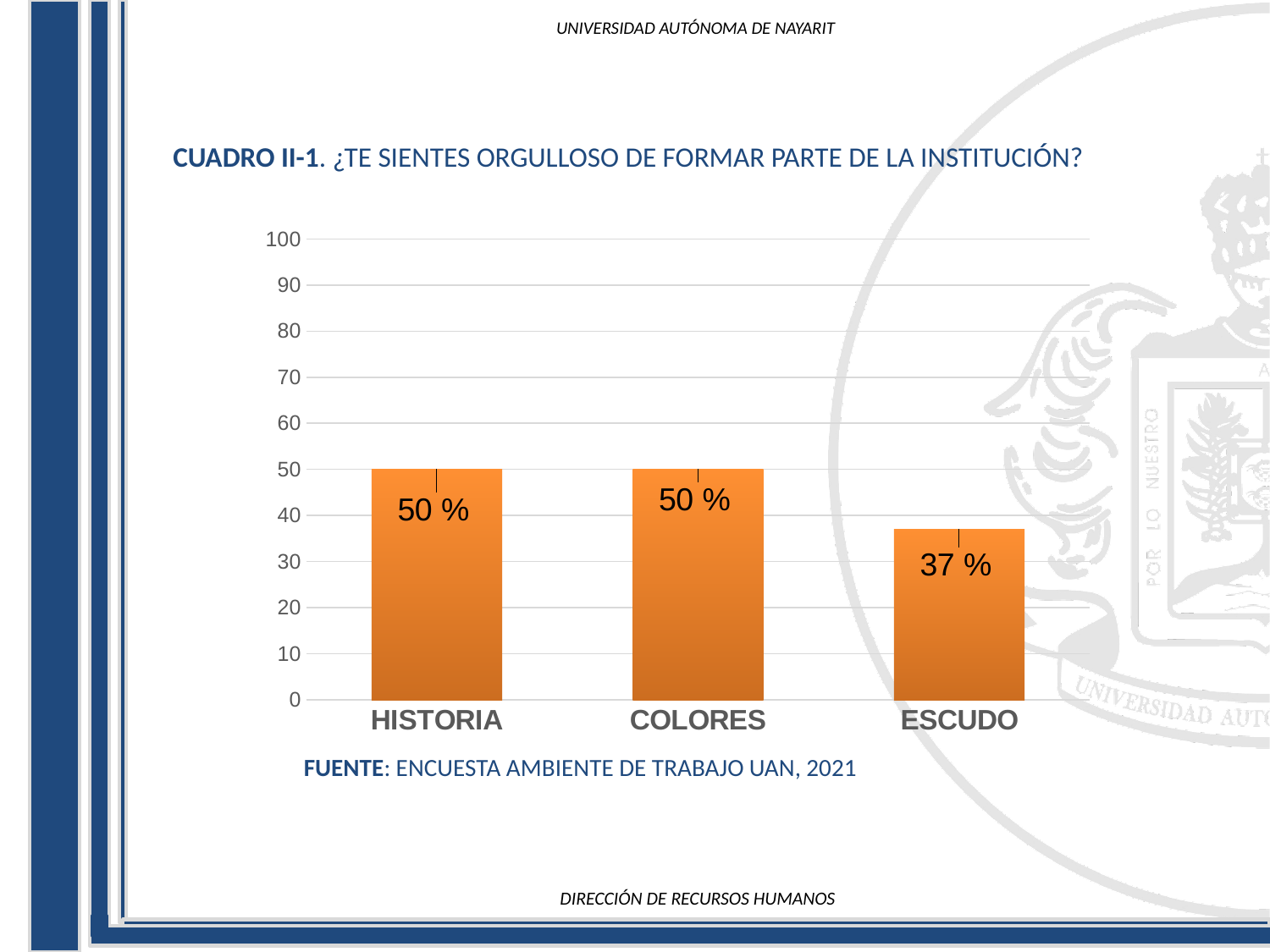
What source is cited below the chart? ENCUESTA AMBIENTE DE TRABAJO UAN, 2021 What is the value for HISTORIA? 50 % What is the value for COLORES? 50 % How many categories are shown on the x axis? 3 What kind of chart is shown on the slide? bar chart Which is larger, the value for COLORES or the value for ESCUDO? COLORES What is the maximum value shown on the vertical axis? 100 Which category has the lowest value? ESCUDO Is the value for ESCUDO greater or less than 40? less What is the value for ESCUDO? 37 % What is the difference between the values for HISTORIA and ESCUDO? 13 %